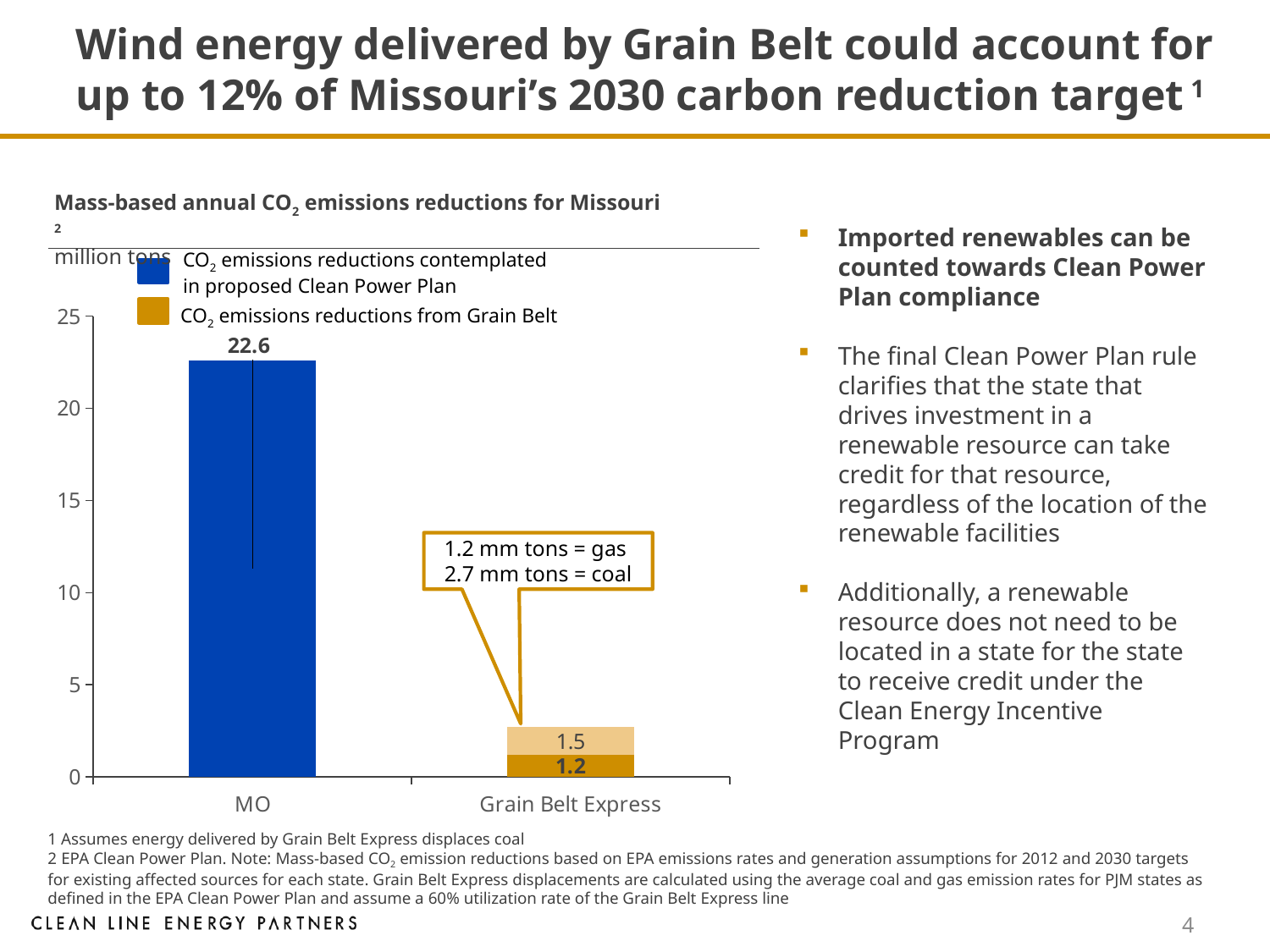
What is the total of the stacked Grain Belt Express bar? 2.7 How many series does the legend list? 2 Is the total for Grain Belt Express greater or less than 5? less What is the value of the top (lighter) segment of the Grain Belt Express bar? 1.5 What is the value of the MO bar? 22.6 Which category has the highest value? MO What kind of chart is shown? Bar chart Is the value for MO greater or less than 20? greater What unit is shown for the y axis of the chart? million tons What is the value of the bottom (darker) segment of the Grain Belt Express bar? 1.2 What is the difference between the MO bar (22.6) and the total of the Grain Belt Express bar (2.7)? 19.9 How many categories are shown on the x axis? 2